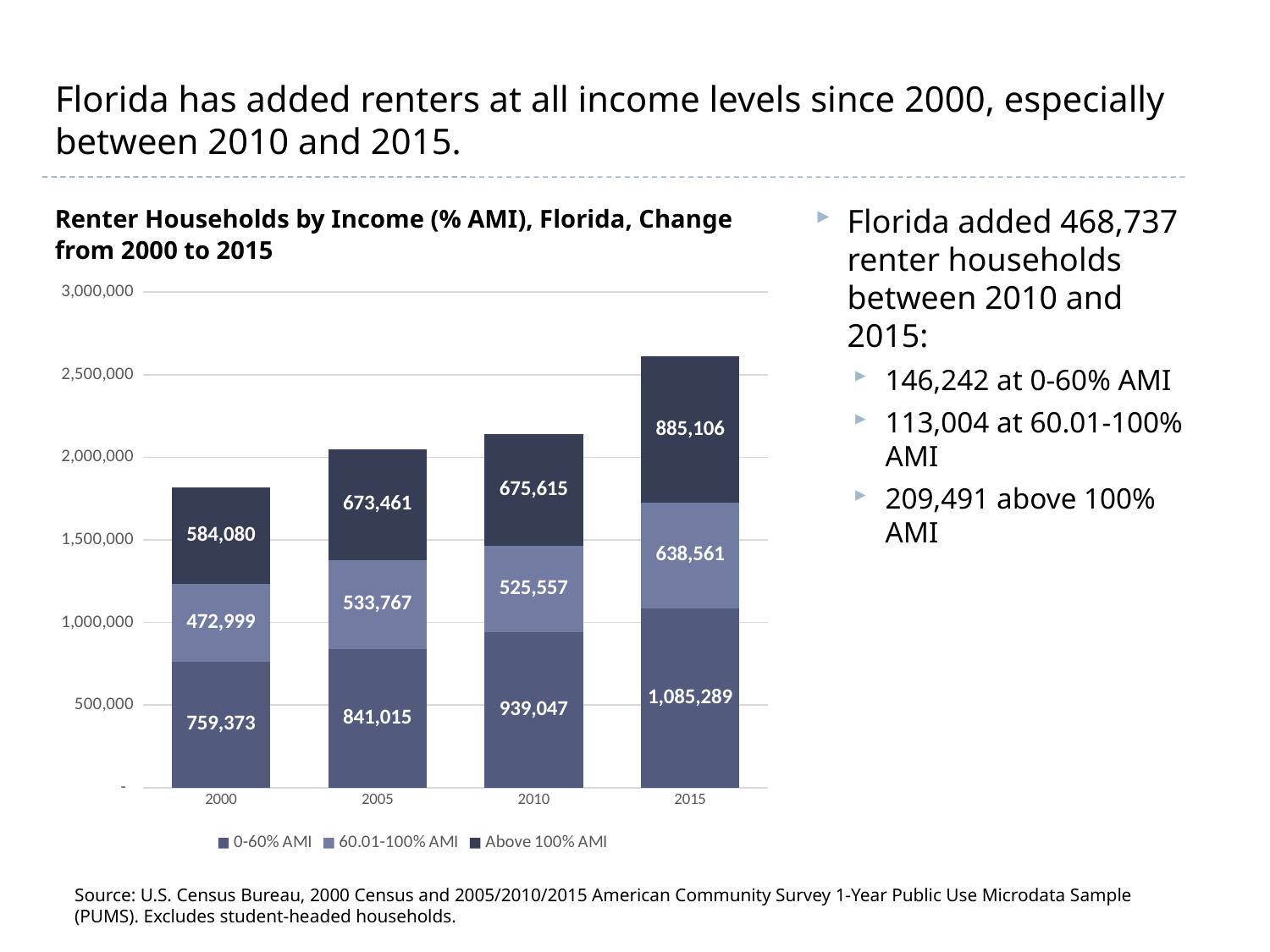
What is the difference between the 0-60% AMI values for 2015 and 2010? 146,242 How many years are shown on the x axis? 4 What is the value for 0-60% AMI in 2015? 1,085,289 Which year has the highest value for 0-60% AMI? 2015 Is the total height of the 2015 stacked bar greater or less than 2,500,000? greater What is the value for Above 100% AMI in 2005? 673,461 How many series does the legend list? 3 What is the value for 60.01-100% AMI in 2010? 525,557 Which is larger: the Above 100% AMI value in 2010 or in 2005? 2010 What kind of chart is shown on the slide? Stacked bar chart What is the total of the stacked bar for 2000? 1,816,452 Which year has the lowest value for 60.01-100% AMI? 2000